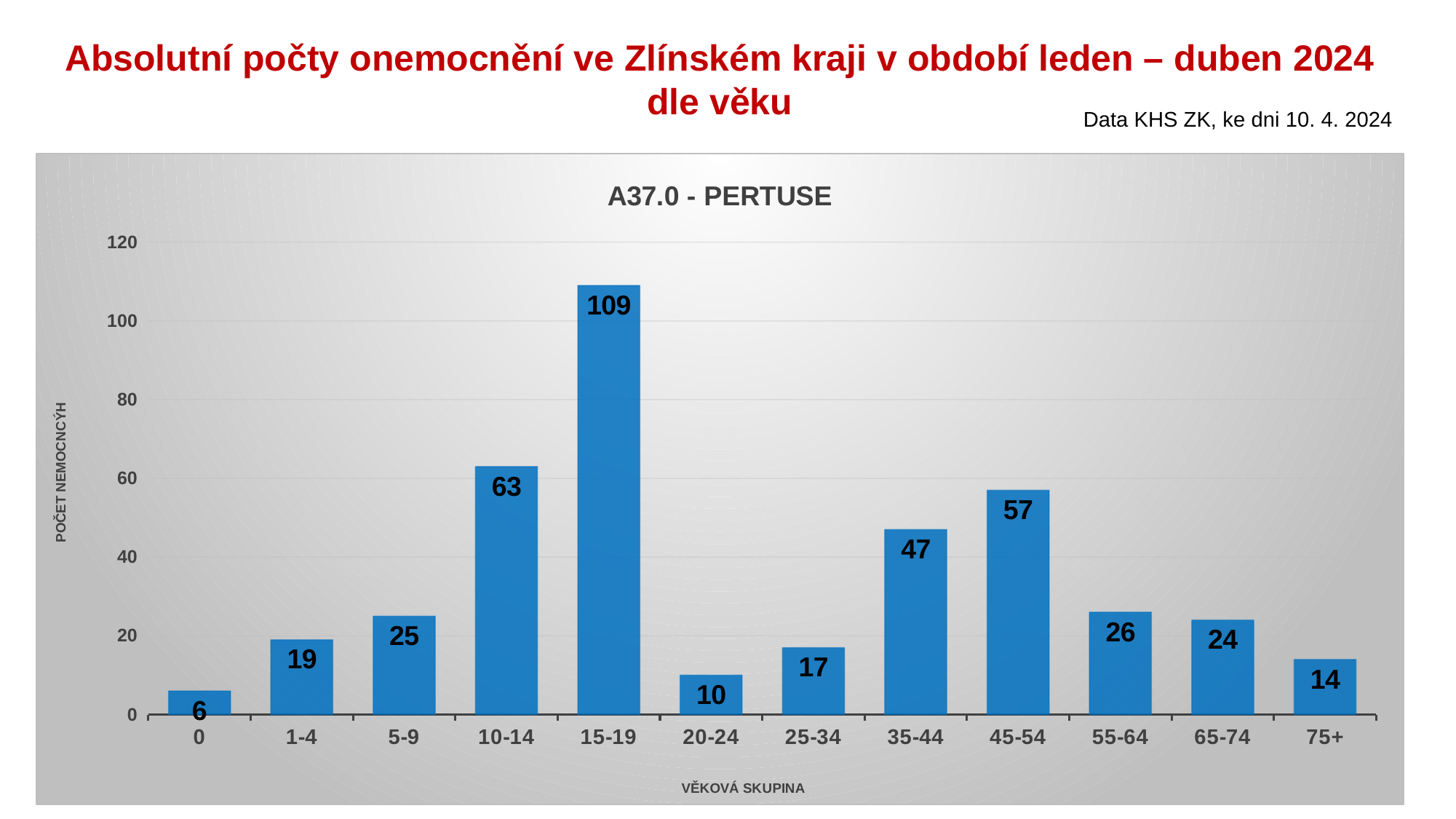
Is the value for 10-14 greater or less than 60? greater What is the difference between the values for 15-19 and 10-14? 46 What is the value for the 0 age group? 6 What is the title of the chart? A37.0 - PERTUSE How many age groups are shown on the x axis? 12 Which age group has the lowest value? 0 What is the value for the 45-54 age group? 57 Which is larger, the value for 5-9 or the value for 55-64? 55-64 What is the value for the 15-19 age group? 109 What is the difference between the values for 45-54 and 35-44? 10 What kind of chart is shown on the slide? bar chart Which age group has the highest value? 15-19